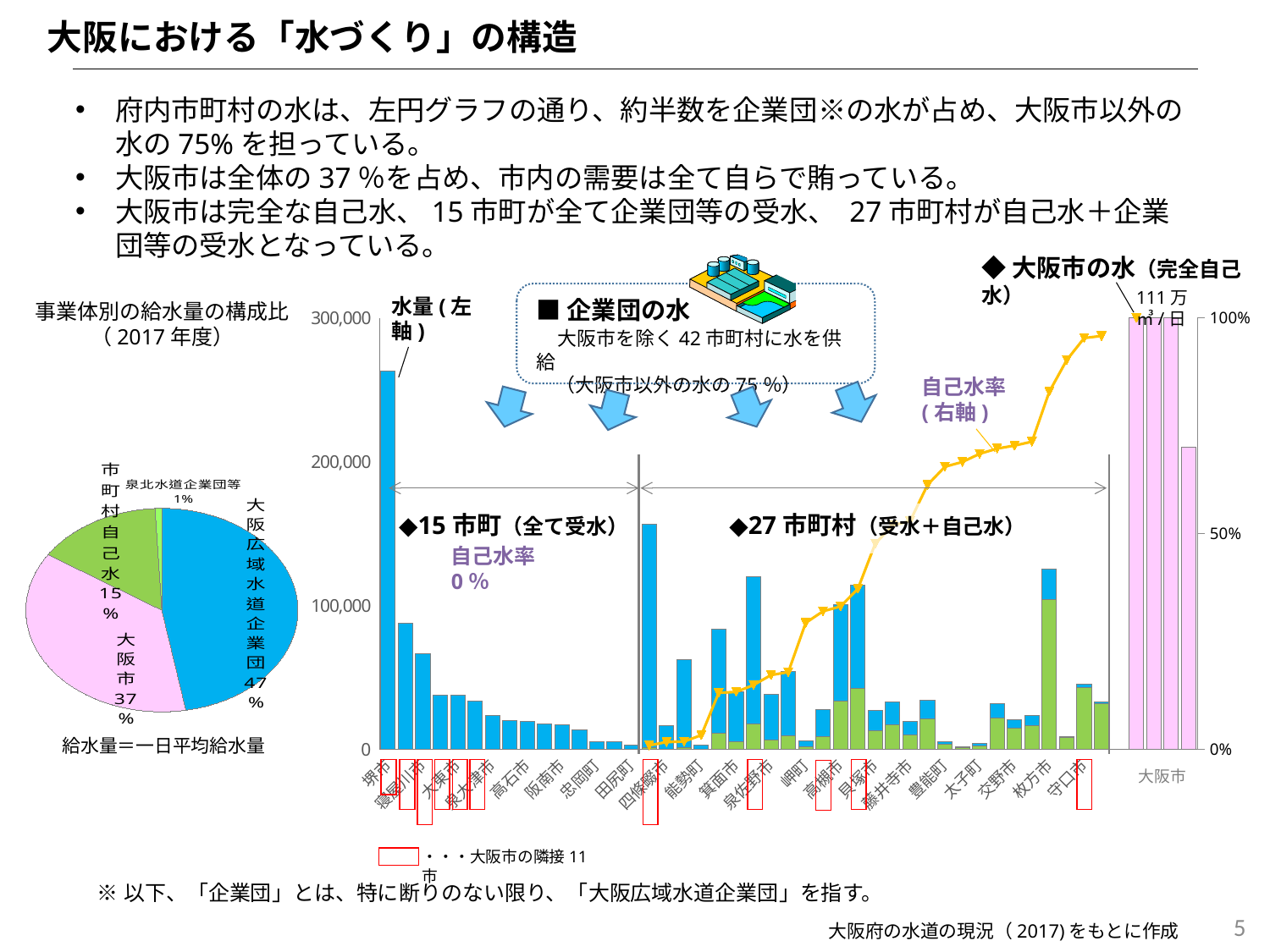
In the pie chart on the left, what share of the water supply is attributed to 大阪広域水道企業団? 47% In the pie chart on the left, what share of the water supply is attributed to 大阪市? 37% In the pie chart on the left, which slice is the smallest? 泉北水道企業団等 In the bar chart on the right, what value is labelled for 大阪市の水? 111万m³/日 In the pie chart on the left, what share is labelled 市町村自己水? 15% In the pie chart on the left, which slice is the largest? 大阪広域水道企業団 In the pie chart on the left, how many slices are there? 4 In the bar chart on the right, what is the 自己水率 for the 15 市町 group labelled 全て受水? 0% In the bar chart on the right, is the 水量 value for 堺市 greater or less than 200,000? greater What kind of chart is the chart on the left of the slide? Pie chart In the pie chart on the left, how many percentage points larger is the 大阪広域水道企業団 slice than the 大阪市 slice? 10